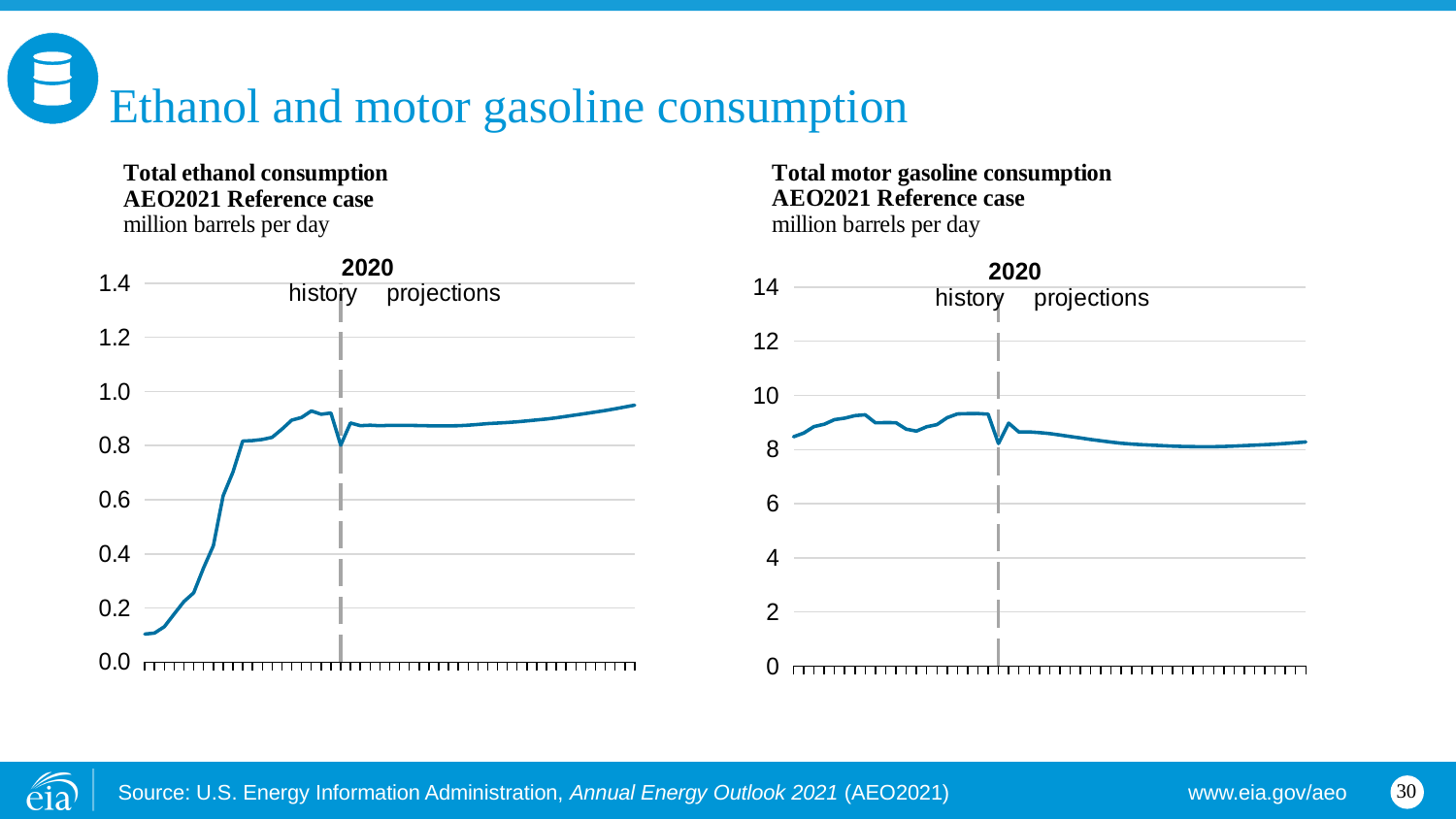
In the 'Total ethanol consumption' chart, does the line generally rise or fall over the history period? rise In the 'Total motor gasoline consumption' chart, is the value at the end of the projection period greater or less than 6? greater In the 'Total ethanol consumption' chart, is the value at the 2020 dashed line greater or less than 0.6? greater In the 'Total motor gasoline consumption' chart, is the value at the 2020 dashed line greater or less than 10? less What kind of chart is the 'Total motor gasoline consumption' chart on the right? line chart How many lines are plotted in the 'Total ethanol consumption' chart? 1 Which chart shows larger values at the 2020 dashed line, 'Total ethanol consumption' or 'Total motor gasoline consumption'? Total motor gasoline consumption What kind of chart is the 'Total ethanol consumption' chart on the left? line chart What unit is used on the y axis of both charts? million barrels per day